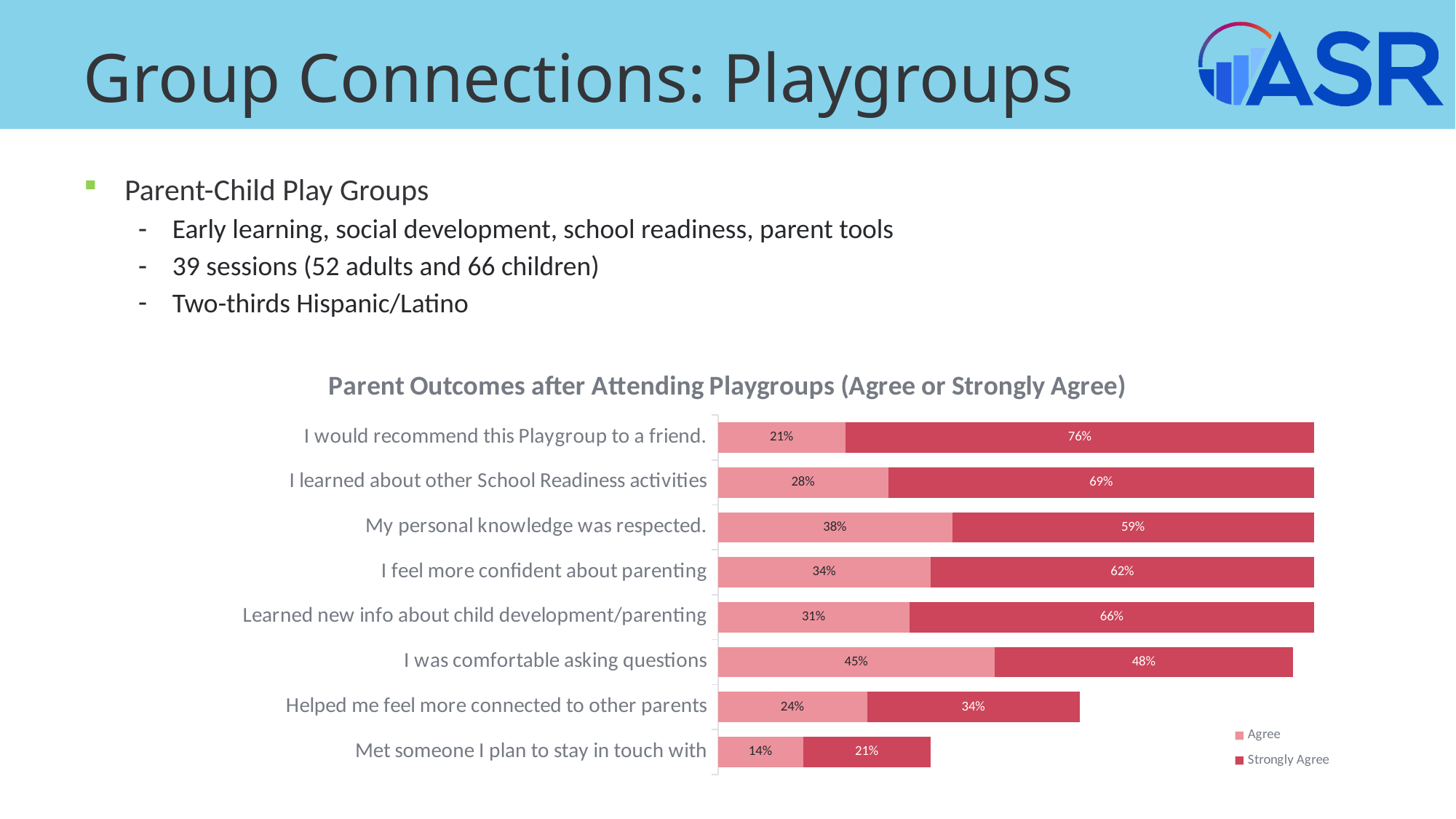
What is the combined Agree and Strongly Agree total for "Met someone I plan to stay in touch with"? 35% What type of chart is shown on the slide? Stacked bar chart What is the Agree value for "I was comfortable asking questions"? 45% What is the Strongly Agree value for "I would recommend this Playgroup to a friend."? 76% What is the Strongly Agree value for "Helped me feel more connected to other parents"? 34% What is the title of the chart? Parent Outcomes after Attending Playgroups (Agree or Strongly Agree) Which statement has the lowest Agree value? Met someone I plan to stay in touch with How many statements (categories) are plotted in the chart? 8 How many series does the chart legend list? 2 For "I was comfortable asking questions", which is larger: the Agree value or the Strongly Agree value? Strongly Agree What is the difference between the Strongly Agree values for "I would recommend this Playgroup to a friend." and "Met someone I plan to stay in touch with"? 55 percentage points Which statement has the highest Strongly Agree value? I would recommend this Playgroup to a friend.